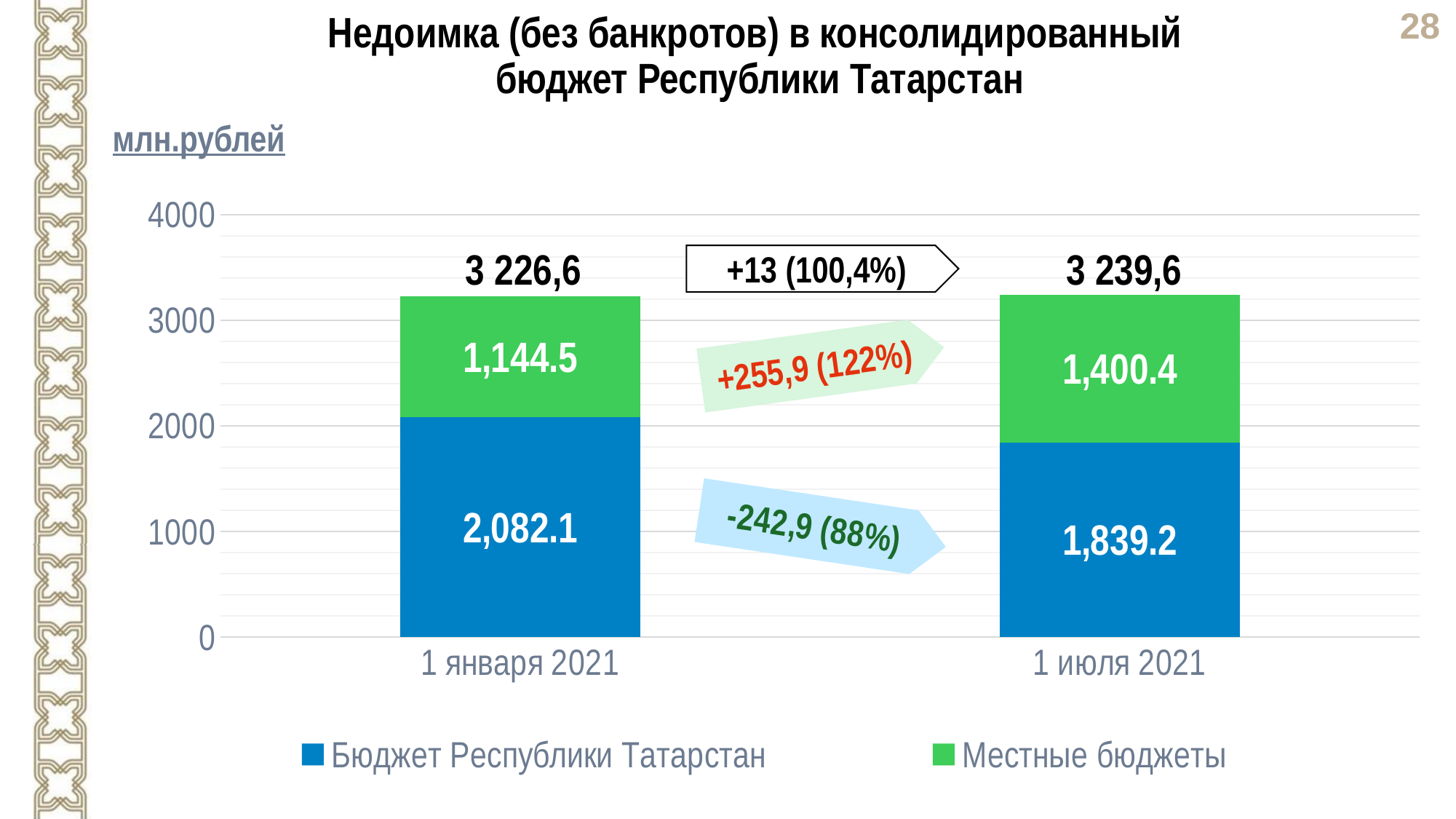
What is the total of the stacked bar for 1 июля 2021? 3 239,6 What is the value for Местные бюджеты on 1 июля 2021? 1,400.4 Which is larger on 1 июля 2021: Бюджет Республики Татарстан or Местные бюджеты? Бюджет Республики Татарстан What kind of chart is shown on the slide? Stacked bar chart What is the value for Местные бюджеты on 1 января 2021? 1,144.5 What is the difference between the Бюджет Республики Татарстан values on 1 января 2021 and 1 июля 2021? 242.9 How many series does the legend list? 2 What is the value for Бюджет Республики Татарстан on 1 июля 2021? 1,839.2 Which colour represents Местные бюджеты in the chart? Green What is the value for Бюджет Республики Татарстан on 1 января 2021? 2,082.1 How many categories are shown on the x axis? 2 What is the total of the stacked bar for 1 января 2021? 3 226,6